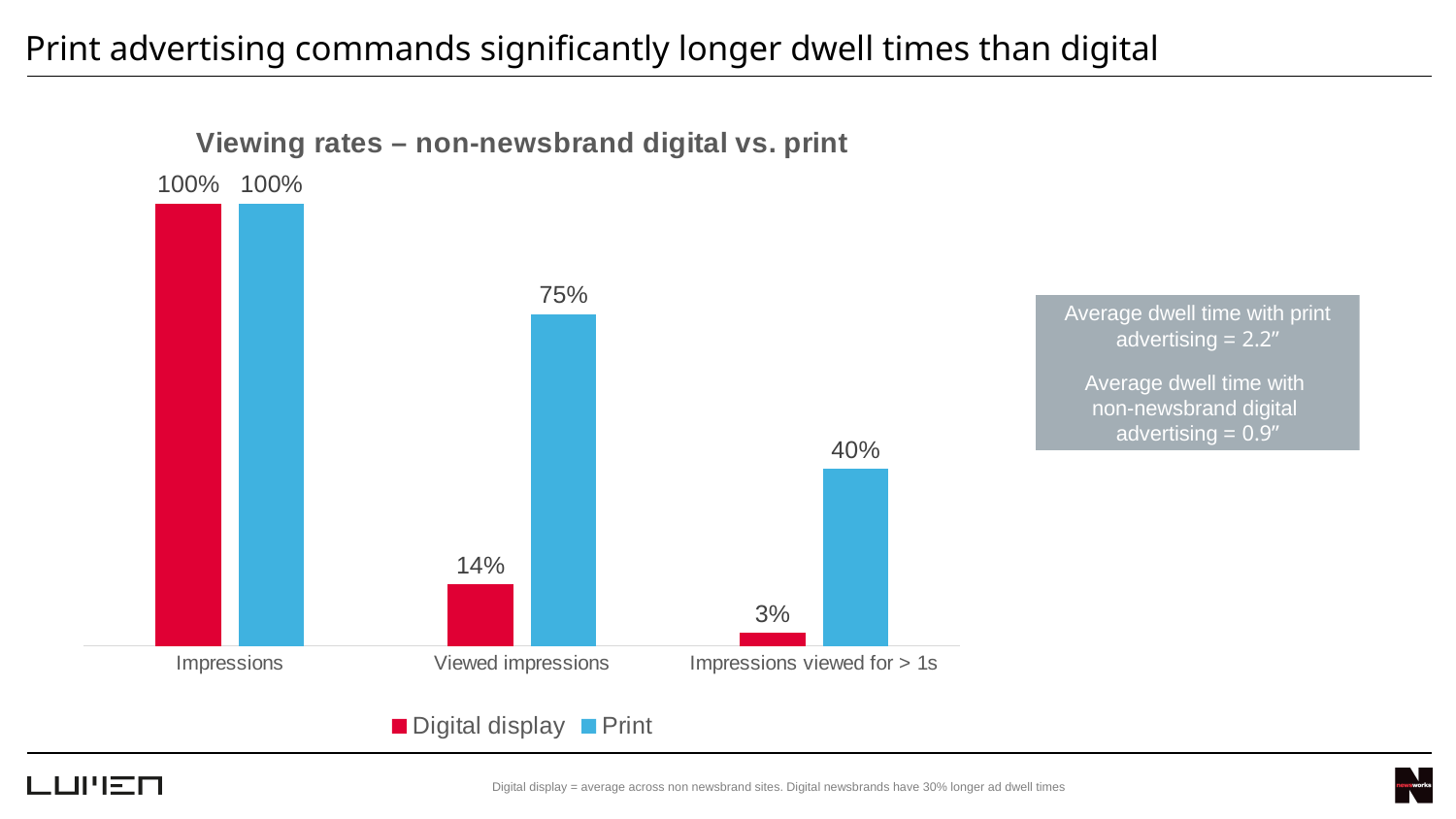
What is the value for Print in the Impressions viewed for > 1s category? 40% What is the value for Print in the Viewed impressions category? 75% What is the value for Digital display in the Impressions viewed for > 1s category? 3% What is the difference between the Print and Digital display values for Impressions viewed for > 1s? 37% What is the value for Digital display in the Viewed impressions category? 14% What type of chart is shown on the slide? Bar chart Which is larger for Viewed impressions, Digital display or Print? Print What is the difference between the Print and Digital display values for Viewed impressions? 61% Which category has the highest value for Print? Impressions Which category has the lowest value for Digital display? Impressions viewed for > 1s How many categories are shown on the x axis? 3 How many series does the legend list? 2